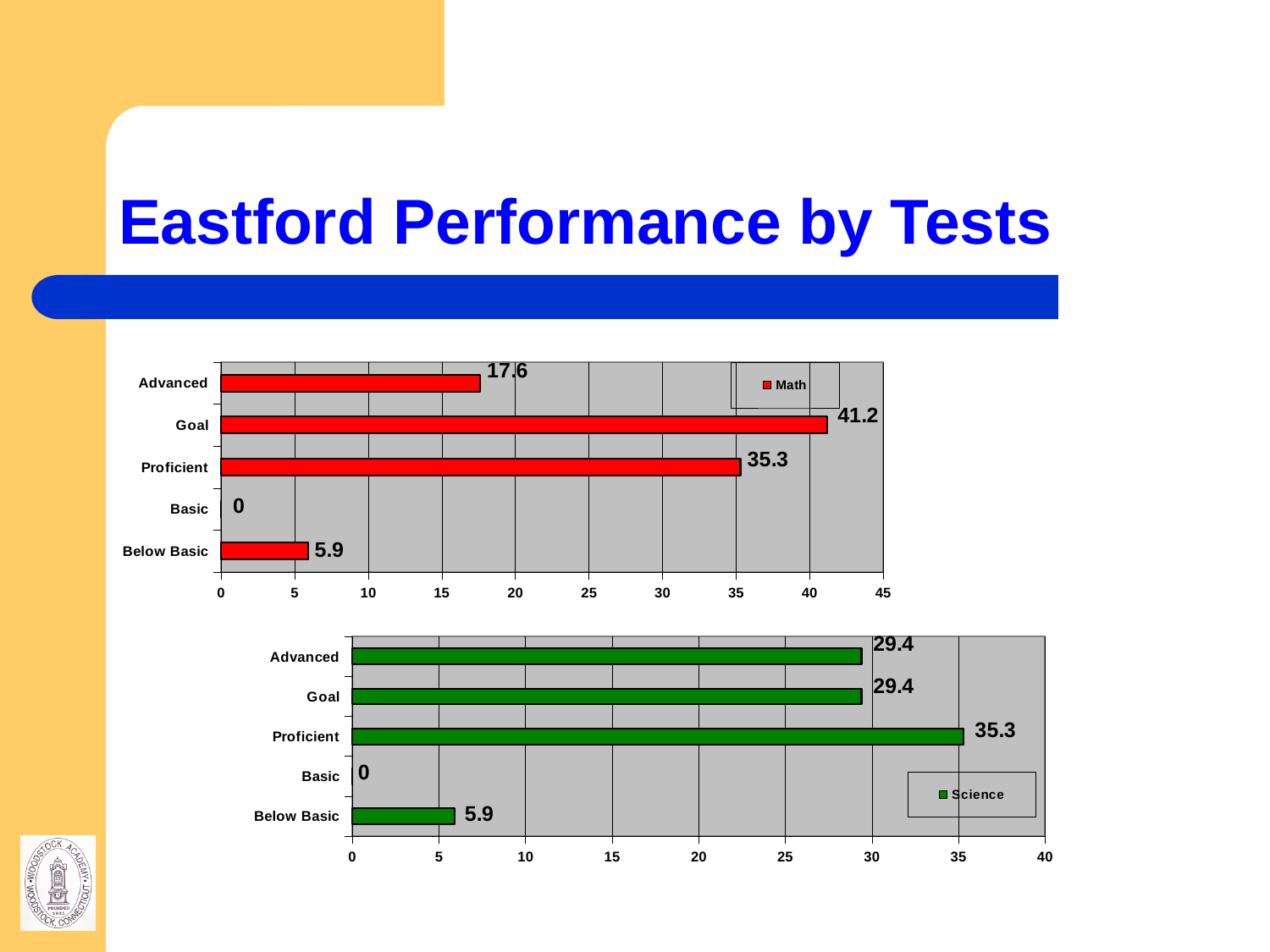
In the top (Math) chart, which category has the highest value? Goal In the top (Math) chart, what is the value for Advanced? 17.6 In the bottom (Science) chart, what is the difference between the Proficient and Advanced values? 5.9 In the top (Math) chart, which category has the lowest value? Basic In the bottom (Science) chart, what is the value for Below Basic? 5.9 Which is larger: the Advanced value in the top (Math) chart or the Advanced value in the bottom (Science) chart? Science In the bottom (Science) chart, which category has the highest value? Proficient In the top (Math) chart, what is the value for Goal? 41.2 What type of chart is the top (Math) chart? Bar chart In the bottom (Science) chart, what is the value for Proficient? 35.3 In the top (Math) chart, what is the difference between the Goal and Proficient values? 5.9 How many categories are shown in the bottom (Science) chart? 5